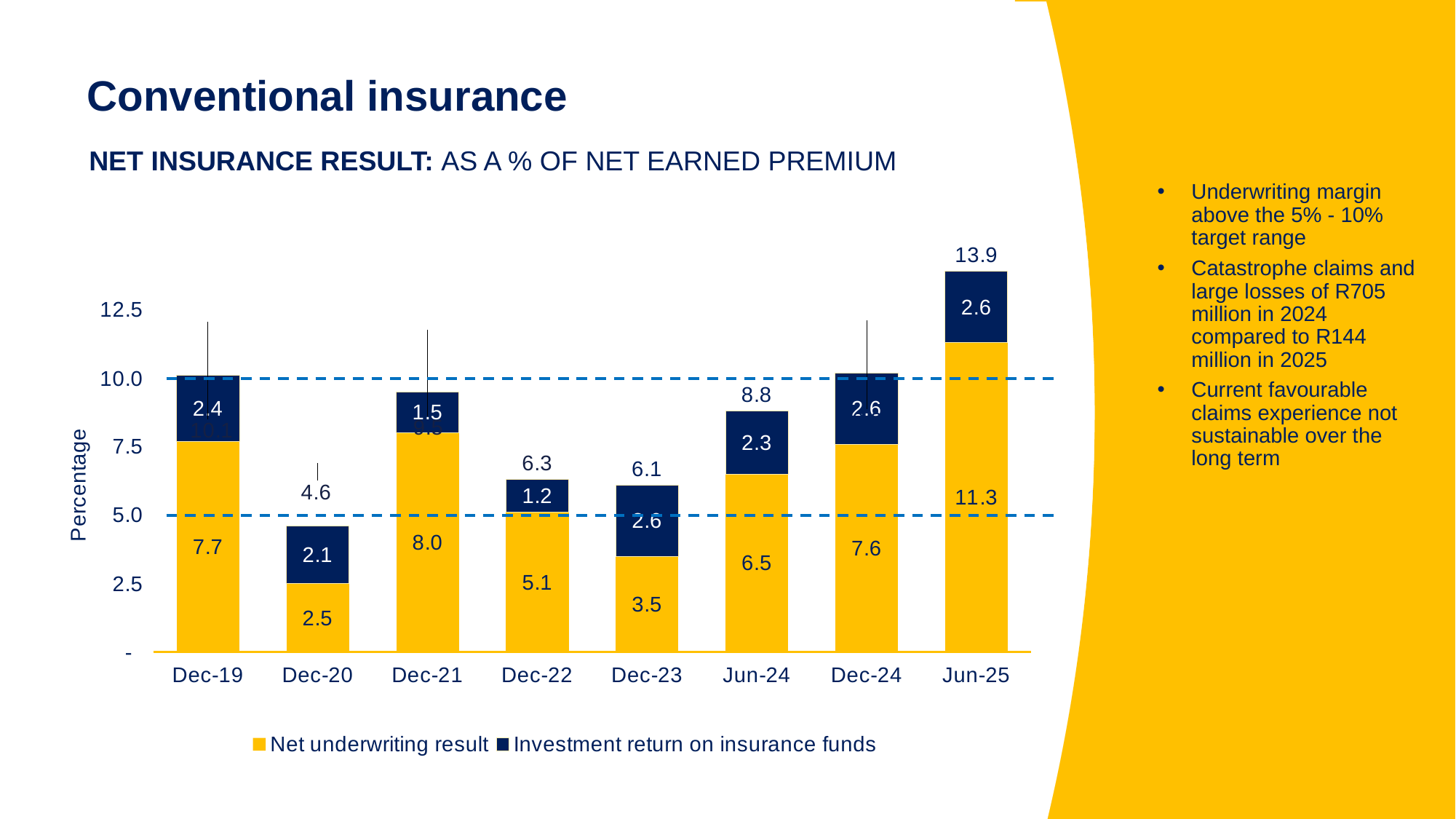
Which period has the lowest net underwriting result? Dec-20 Which is larger, the investment return on insurance funds for Dec-23 or for Dec-22? Dec-23 What is the investment return on insurance funds for Dec-22? 1.2 What is the difference between the net underwriting result for Jun-25 and Dec-24? 3.7 Which period has the lowest investment return on insurance funds? Dec-22 How many series does the legend list? 2 What kind of chart is shown on the slide? Stacked bar chart What is the total net insurance result for Jun-24? 8.8 What is the total of the stacked bar for Dec-20? 4.6 Which period has the highest net underwriting result? Jun-25 What is the net underwriting result for Jun-25? 11.3 How many periods are shown on the x axis? 8